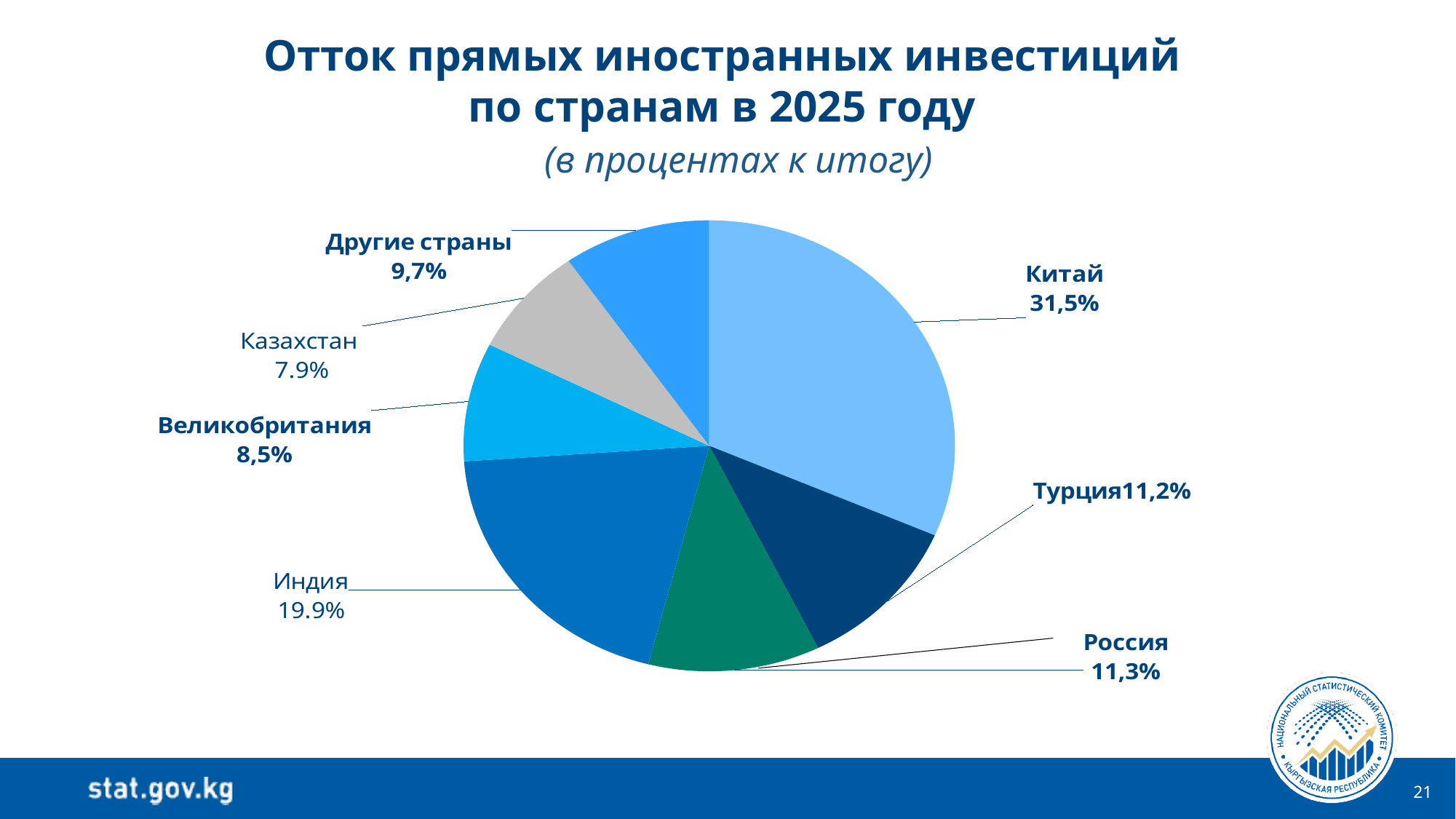
What is the difference between the shares of Китай and Россия? 20,2% Which category has the smallest share of the pie? Казахстан Which country has the largest share of the pie? Китай What kind of chart is shown on the slide? pie chart What share of the pie does Китай have? 31,5% What is the value shown for Великобритания? 8,5% What is the value shown for Другие страны? 9,7% What is the difference between the shares of Другие страны and Великобритания? 1,2% What is the value shown for Индия? 19.9% Which has a larger share, Индия or Россия? Индия How many slices does the pie chart have? 7 What is the value shown for Казахстан? 7.9%